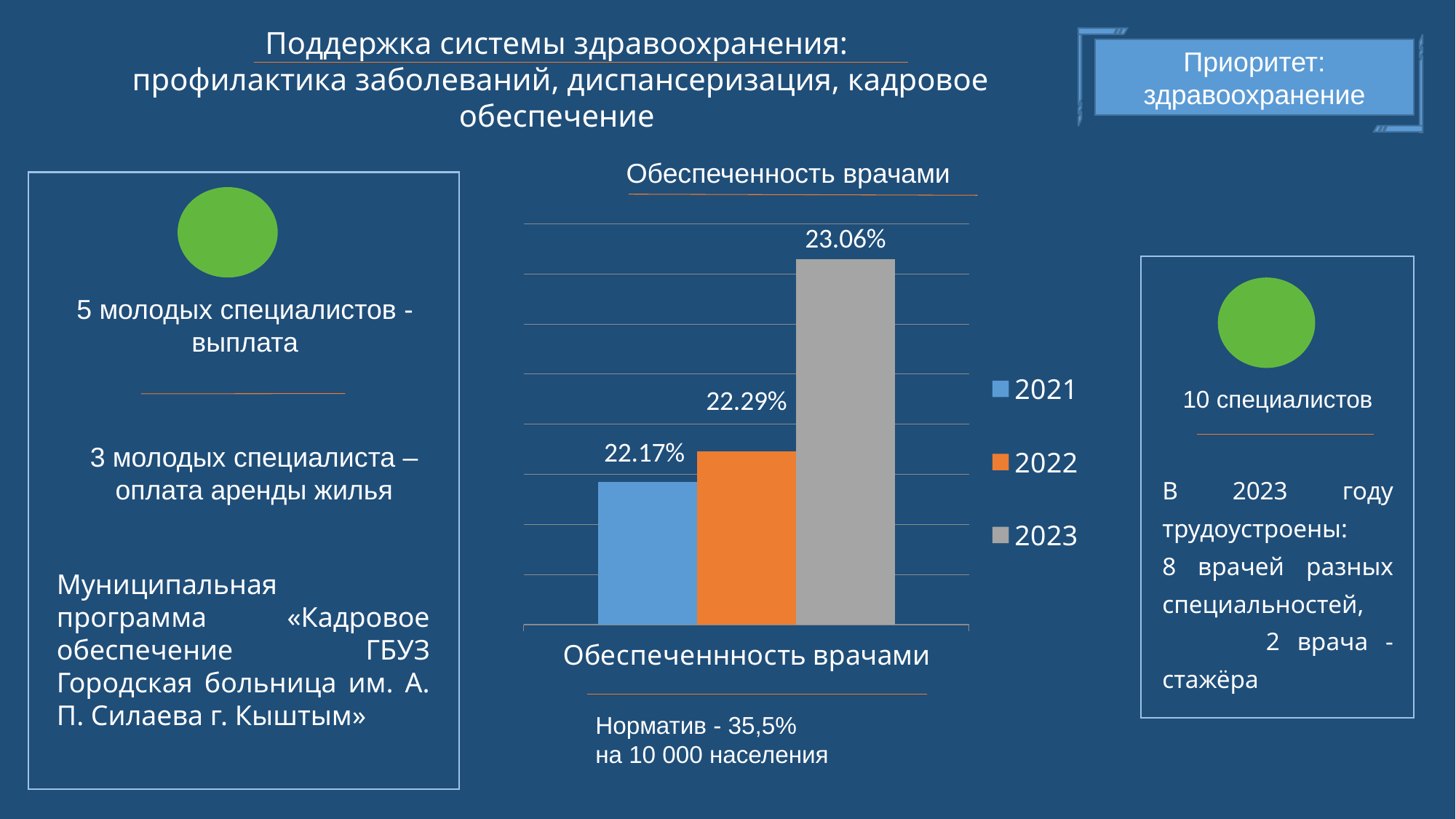
What is the difference between the 2023 and 2021 values? 0.89% How many series does the legend list? 3 Which is larger, the value for 2023 or the value for 2022? 2023 Which year has the highest value in the chart? 2023 What is the difference between the 2022 and 2021 values? 0.12% Do the values rise or fall from 2021 to 2023? Rise What is the value for 2021 in the chart? 22.17% What is the value for 2023 in the chart? 23.06% What is the title of the chart? Обеспеченность врачами What kind of chart is shown on the slide? Bar chart Which year has the lowest value in the chart? 2021 What is the value for 2022 in the chart? 22.29%